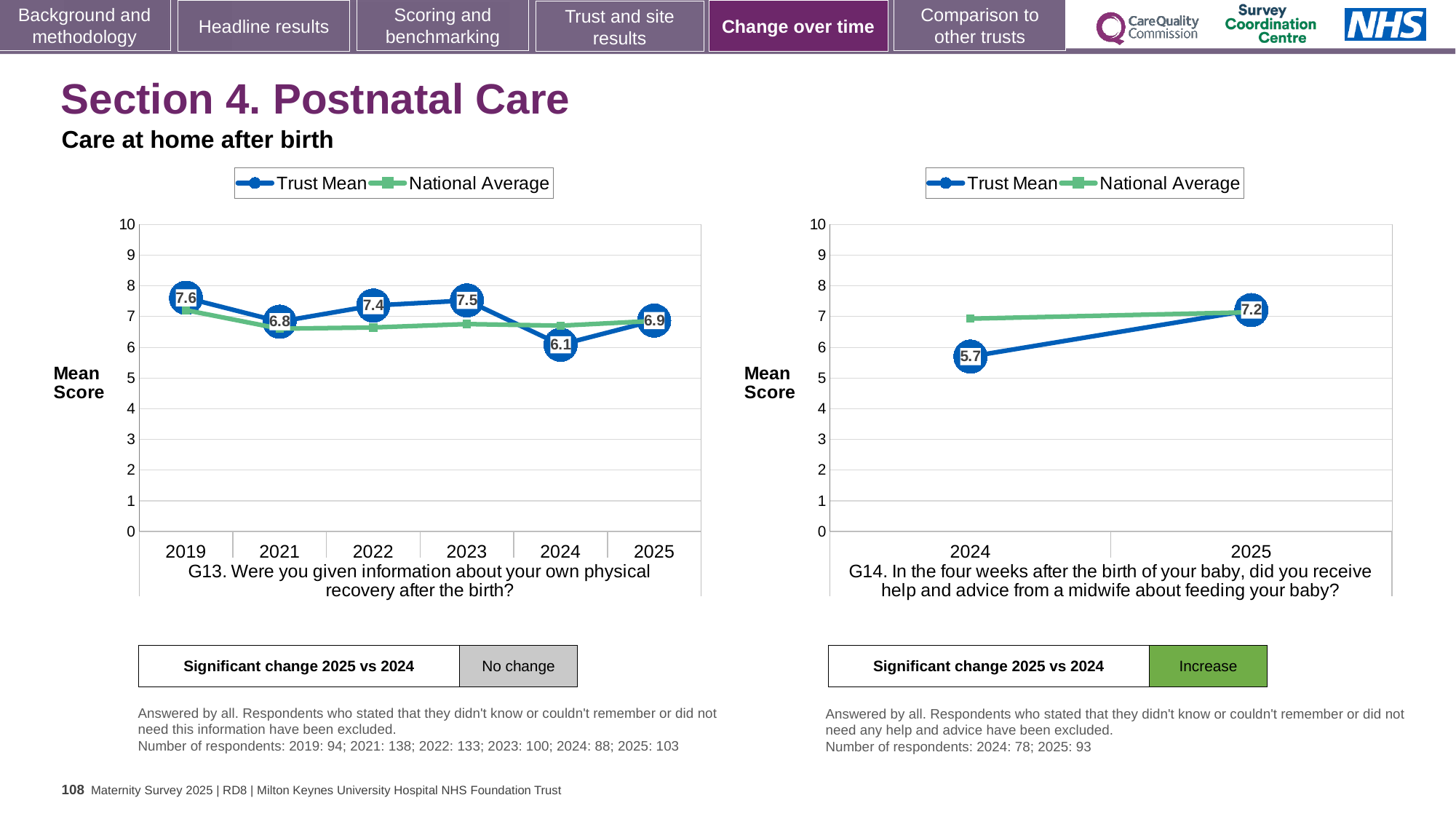
In the G13 chart on the left, what is the Trust Mean score for 2019? 7.6 In the G13 chart on the left, what is the Trust Mean score for 2024? 6.1 In the G13 chart on the left, how many years are shown on the x axis? 6 In the G13 chart on the left, which year has the lowest Trust Mean score? 2024 In the G14 chart on the right, is the Trust Mean for 2024 greater or less than the National Average for 2024? less In the G13 chart on the left, what is the difference between the Trust Mean scores for 2023 and 2024? 1.4 In the G14 chart on the right, what is the Trust Mean score for 2025? 7.2 In the G14 chart on the right, what is the Trust Mean score for 2024? 5.7 How many series does the legend of the G14 chart on the right list? 2 In the G13 chart on the left, which year has the highest Trust Mean score? 2019 In the G13 chart on the left, is the National Average for 2019 greater or less than 8? less In the G14 chart on the right, does the Trust Mean rise or fall from 2024 to 2025? rise